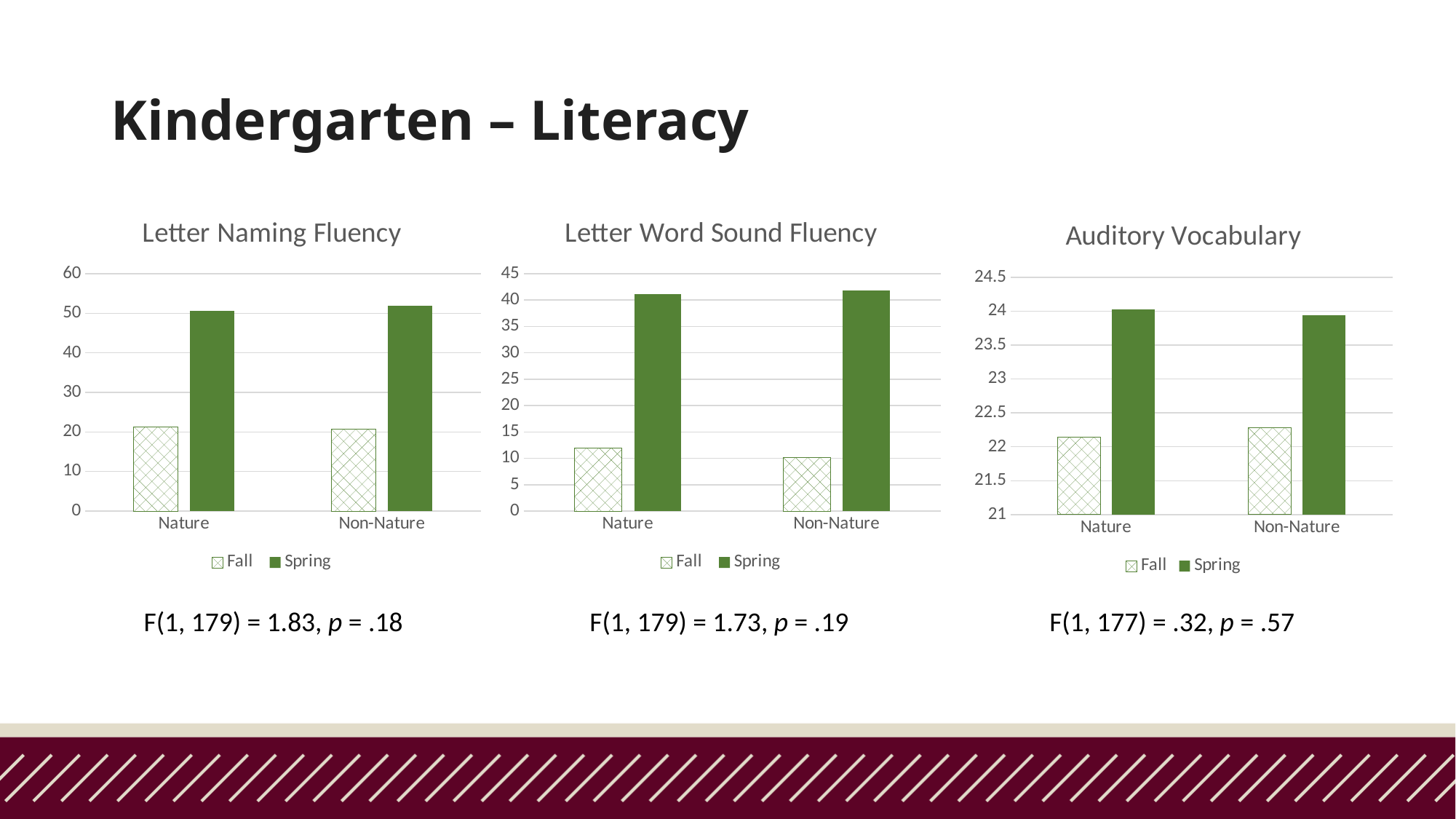
In the Letter Word Sound Fluency chart, is the Fall value for Non-Nature greater or less than 15? less What are the two legend entries in the Auditory Vocabulary chart? Fall and Spring In the Letter Naming Fluency chart, is the Spring value for Nature greater or less than 40? greater How many categories are shown on the x axis of the Auditory Vocabulary chart? 2 In the Auditory Vocabulary chart, is the Fall value for Nature greater or less than 22.5? less How many series does the legend of the Letter Word Sound Fluency chart list? 2 What kind of chart is the Letter Naming Fluency chart? bar chart In the Letter Word Sound Fluency chart, which category has the larger Fall value, Nature or Non-Nature? Nature In the Letter Naming Fluency chart, which is larger for Nature, the Fall value or the Spring value? Spring